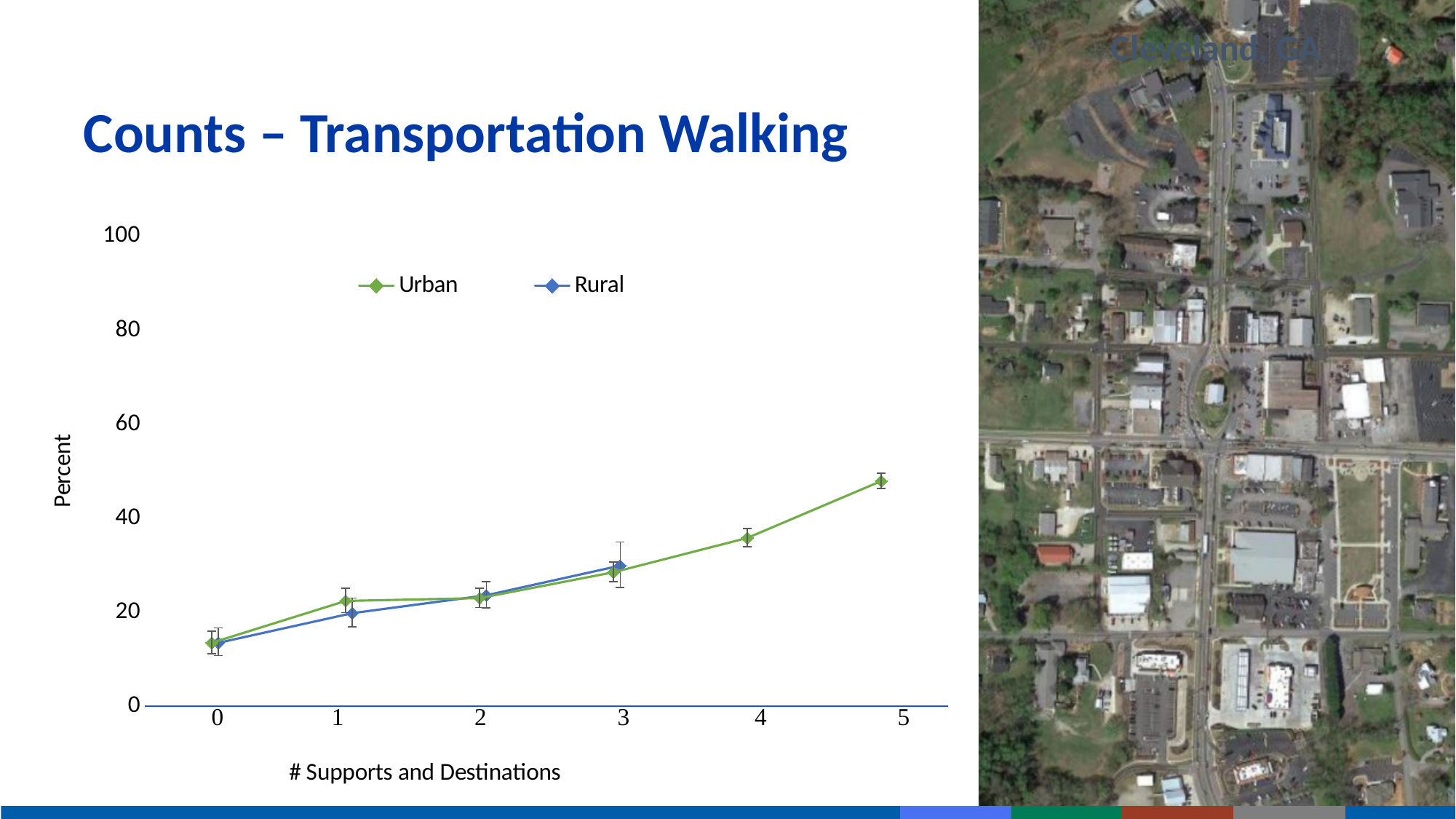
Is the Urban value at 5 supports and destinations greater or less than 40? greater At which number of supports and destinations is the Urban series highest? 5 How many series does the legend list? 2 At which number of supports and destinations is the Urban series lowest? 0 Does the Urban series rise or fall as the number of supports and destinations increases? rise How many data points are plotted for the Urban series? 6 What is the label of the x axis? # Supports and Destinations What kind of chart is shown on the slide? line chart Which is larger for the Urban series: the value at 0 or the value at 4 supports and destinations? 4 Is the Urban value at 5 supports and destinations greater or less than 60? less Is the Rural value at 3 supports and destinations greater or less than 40? less What is the title of the chart? Counts – Transportation Walking